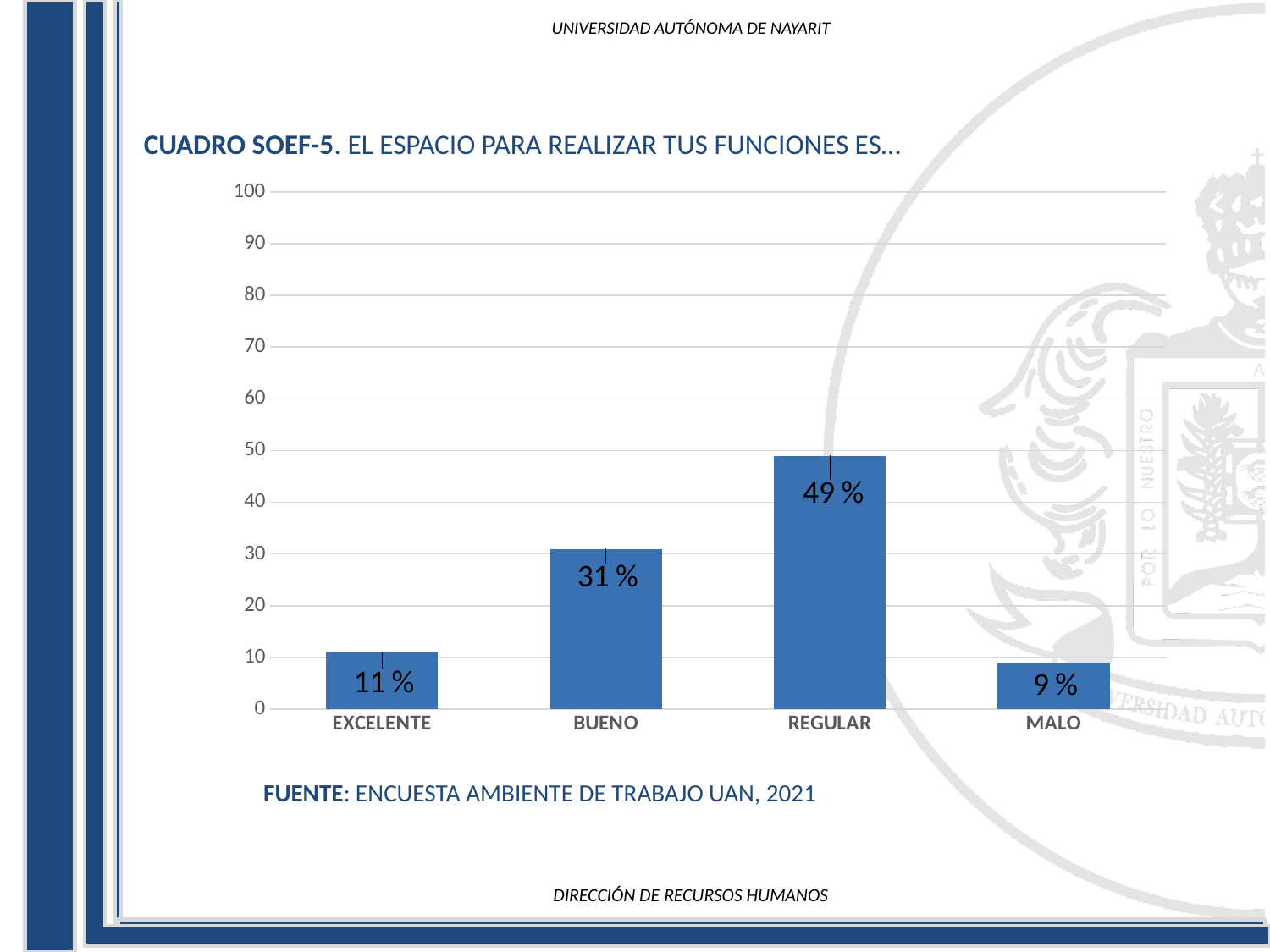
What kind of chart is shown on the slide? bar chart What is the value for BUENO? 31 % What is the difference between the values for REGULAR and BUENO? 18 % Which is larger, the value for EXCELENTE or the value for MALO? EXCELENTE How many categories are shown on the x axis? 4 What is the value for MALO? 9 % Which category has the highest value? REGULAR What is the value for REGULAR? 49 % What is the source cited below the chart? ENCUESTA AMBIENTE DE TRABAJO UAN, 2021 Which category has the lowest value? MALO Is the value for BUENO greater or less than 40? less What is the value for EXCELENTE? 11 %